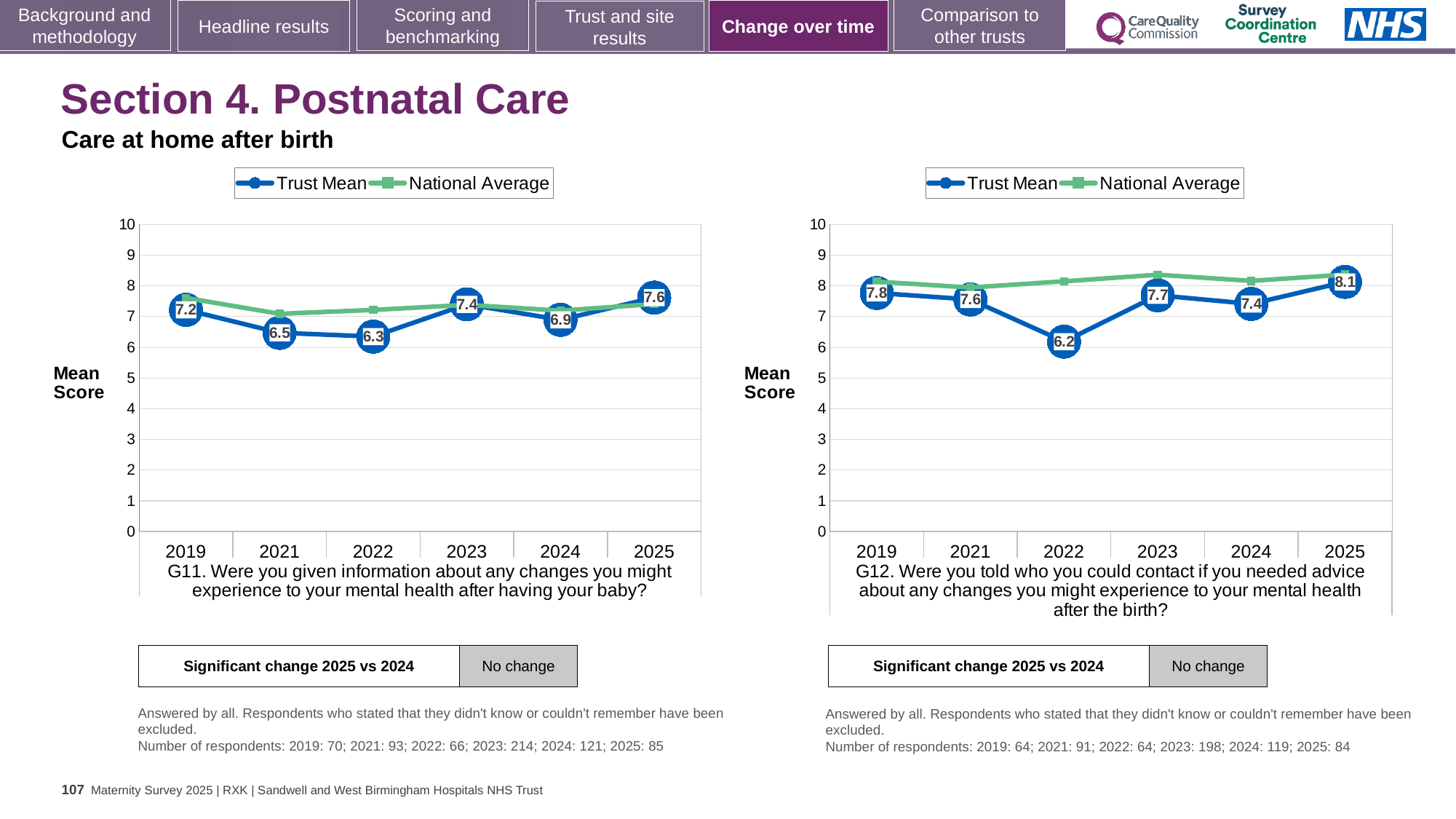
What type of chart is the G12 chart (right)? line chart In the G12 chart (right), which year has the highest Trust Mean? 2025 In the G11 chart (left), what is the Trust Mean for 2022? 6.3 In the G11 chart (left), which year has the highest Trust Mean? 2025 How many years are plotted on the x axis of the G11 chart (left)? 6 In the G12 chart (right), is the Trust Mean for 2019 higher or lower than the Trust Mean for 2021? higher In the G11 chart (left), which year has the lowest Trust Mean? 2022 In the G12 chart (right), what is the difference between the Trust Mean in 2023 and in 2022? 1.5 In the G11 chart (left), what is the difference between the Trust Mean in 2025 and in 2024? 0.7 In the G12 chart (right), is the National Average for 2023 greater or less than 8? greater In the G12 chart (right), what is the Trust Mean for 2022? 6.2 In the G11 chart (left), what is the Trust Mean for 2025? 7.6